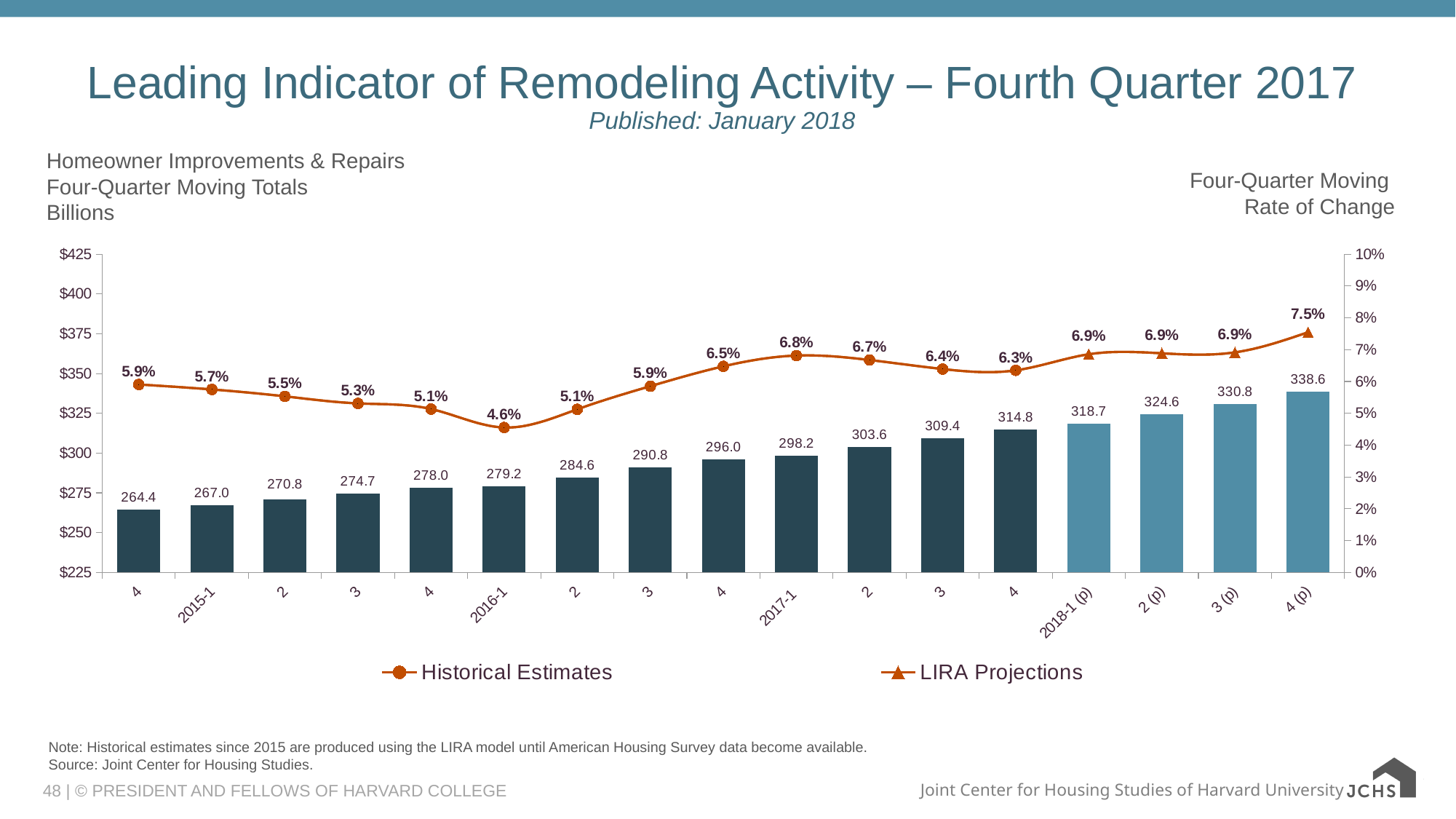
Do the four-quarter moving totals rise or fall from left to right across the chart? Rise Which quarter has the lowest four-quarter moving rate of change? 2016-1 How many bars are plotted on the chart? 17 Which quarter has the highest four-quarter moving total? 4 (p) of 2018 How many series does the legend list? 2 What is the four-quarter moving total for 2016-1? 279.2 What are the two entries in the chart legend? Historical Estimates and LIRA Projections What is the four-quarter moving total for the third quarter of 2015? 274.7 Which has the higher rate of change, the second quarter of 2017 or the third quarter of 2017? Second quarter of 2017 What is the four-quarter moving rate of change for 2017-1? 6.8% What is the difference between the four-quarter moving totals for 2018-1 (p) and the fourth quarter of 2017? 3.9 What kind of chart is shown? Combination bar and line chart